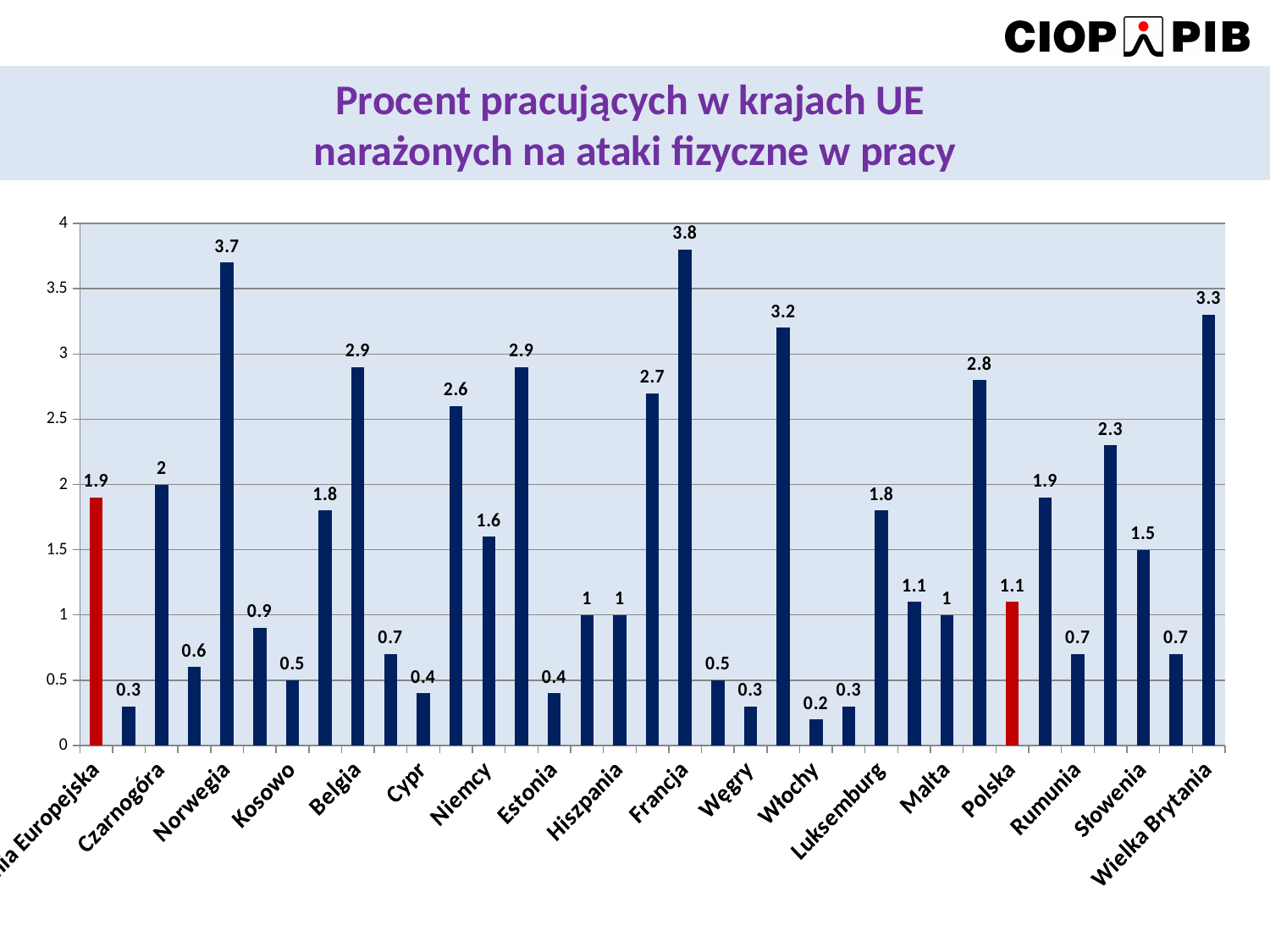
How many bars are plotted in the chart? 35 What is the value for Wielka Brytania? 3.3 Which two bars are coloured red instead of dark blue? Unia Europejska and Polska What is the value for Francja? 3.8 What is the difference between the values for Francja and Polska? 2.7 What is the value for Polska? 1.1 Which is larger, the value for Belgia or the value for Niemcy? Belgia Which labelled country has the highest value? Francja What is the value for Norwegia? 3.7 Which labelled country has the lowest value? Włochy Is the value for Luksemburg greater or less than 1.5? greater What kind of chart is shown on the slide? Bar chart